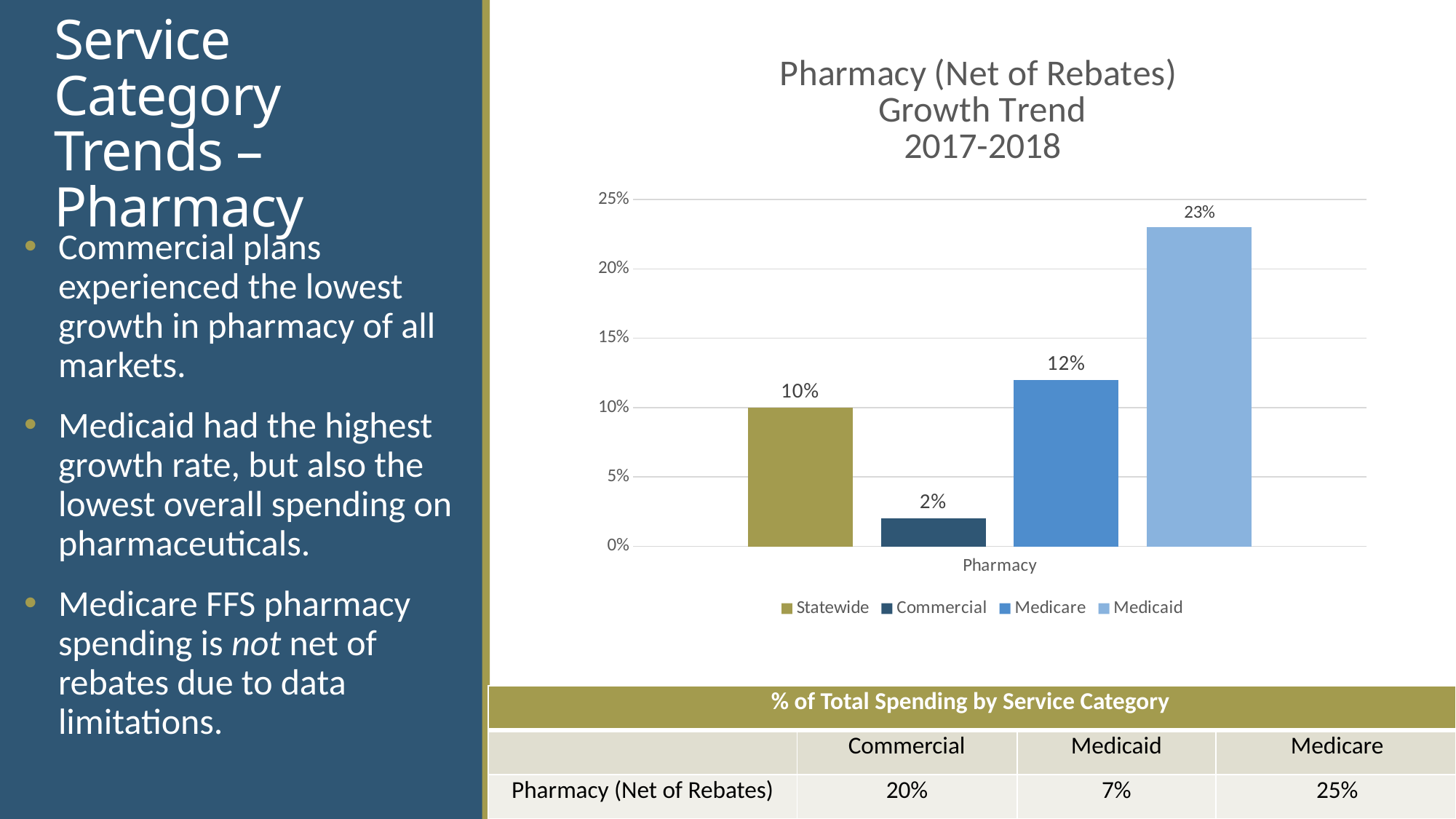
What is the growth trend value for Commercial in the chart? 2% What is the difference between the Medicare and Statewide growth trend values? 2% What is the growth trend value for Medicaid in the chart? 23% What kind of chart is shown on the slide? Bar chart What is the growth trend value for Statewide in the chart? 10% What is the difference between the Medicaid and Commercial growth trend values? 21% Which is larger, the growth trend for Medicare or for Statewide? Medicare What is the growth trend value for Medicare in the chart? 12% How many series does the chart legend list? 4 What is the title of the chart? Pharmacy (Net of Rebates) Growth Trend 2017-2018 Which series has the lowest pharmacy growth trend in the chart? Commercial Which series has the highest pharmacy growth trend in the chart? Medicaid